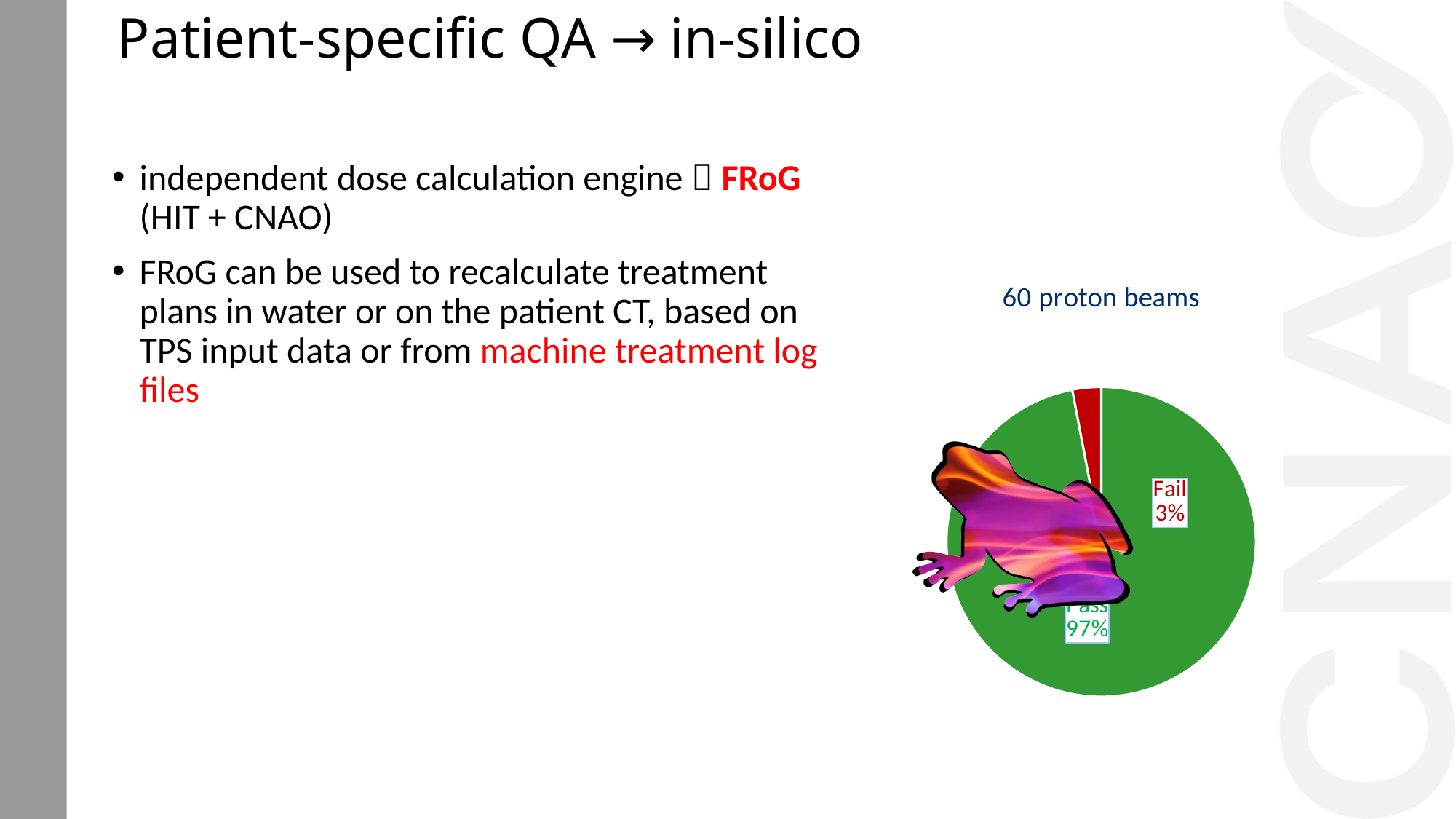
What is the title of the pie chart? 60 proton beams What colour is the Fail slice of the pie chart? red Which slice of the pie chart is the smallest? Fail What kind of chart is shown on the slide? pie chart Which slice of the pie chart is the largest? Pass What is the difference in percentage points between the Pass and Fail slices? 94 What share of the pie does the Pass slice represent? 97% Which is larger in the pie chart, Pass or Fail? Pass What percentage of the pie chart is labelled Fail? 3% How many slices does the pie chart have? 2 What percentage of the pie chart is labelled Pass? 97%